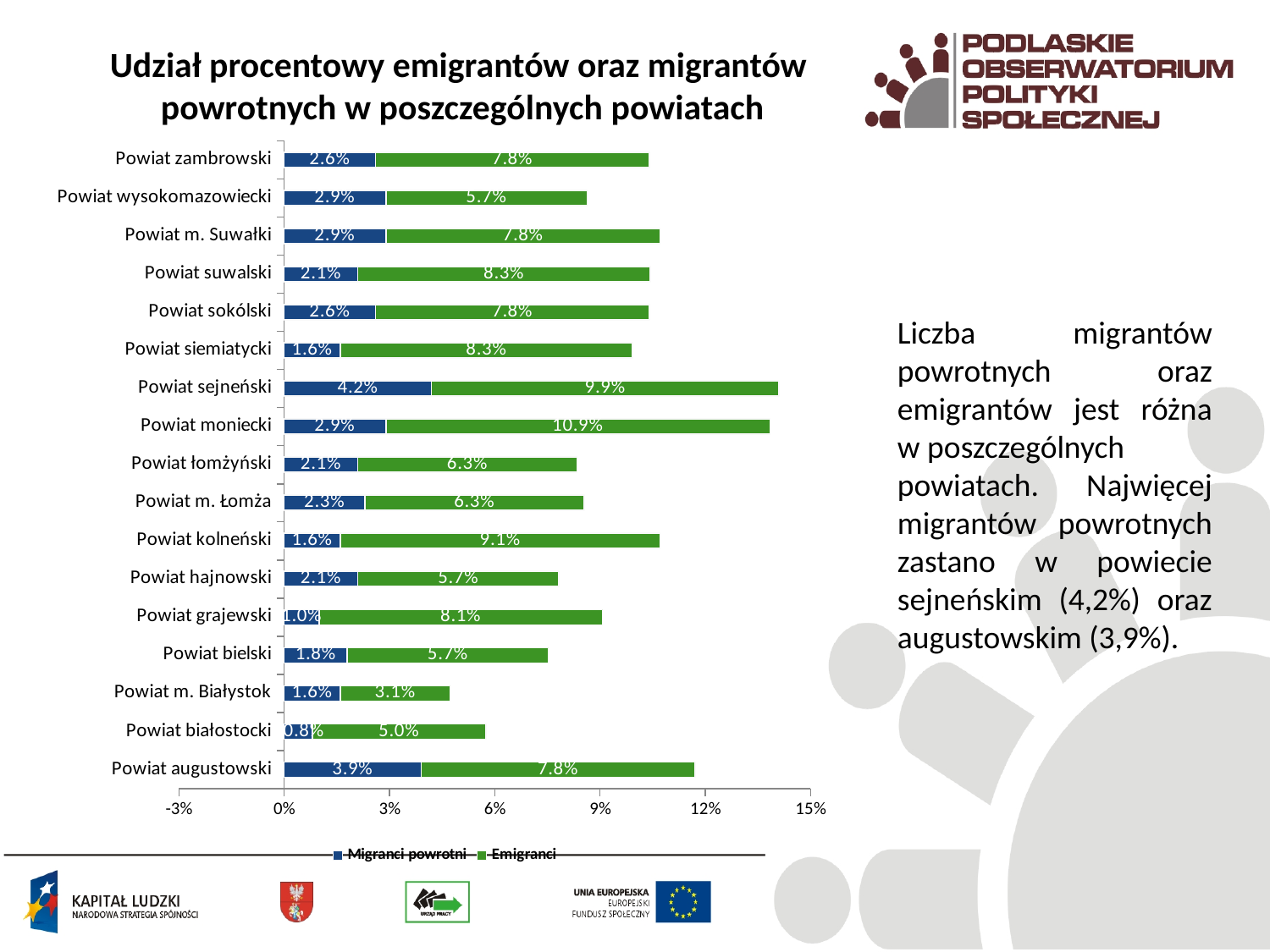
How many series does the legend list? 2 What is the difference between the Migranci powrotni values for Powiat sejneński and Powiat augustowski? 0.3% Which powiat has the highest Emigranci value? Powiat moniecki What type of chart is shown on the slide? bar chart Which powiat has the highest Migranci powrotni value? Powiat sejneński What is the Migranci powrotni value for Powiat białostocki? 0.8% Which is larger, the Emigranci value for Powiat kolneński or for Powiat grajewski? Powiat kolneński What is the Migranci powrotni value for Powiat sejneński? 4.2% What is the total of the stacked bar for Powiat sejneński? 14.1% How many powiats (categories) are shown in the chart? 17 What is the Emigranci value for Powiat moniecki? 10.9% Which powiat has the lowest Emigranci value? Powiat m. Białystok